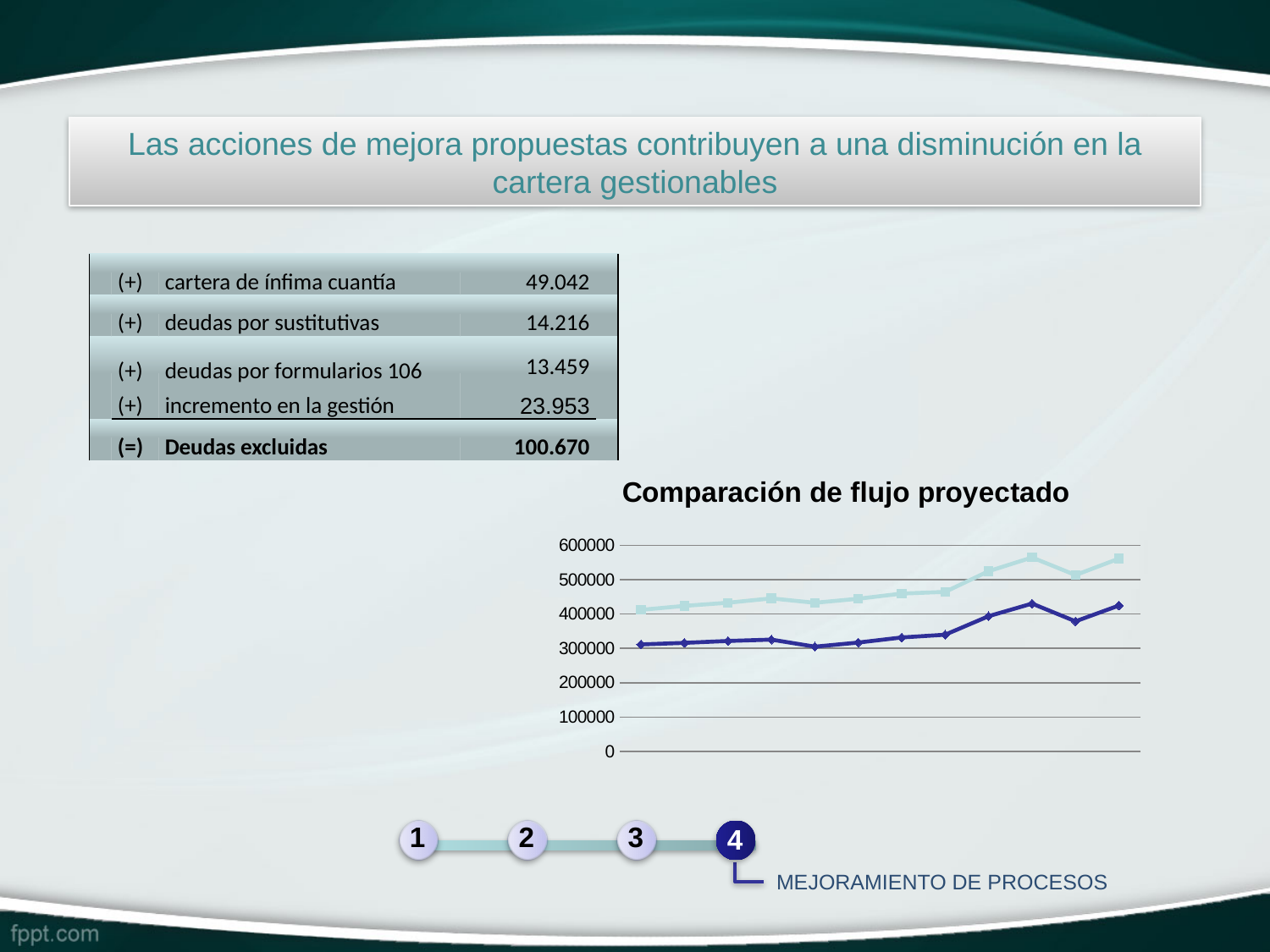
What is the title of the chart on the slide? Comparación de flujo proyectado In the 'Comparación de flujo proyectado' chart, do the values of the light blue line generally rise or fall from left to right? rise In the 'Comparación de flujo proyectado' chart, is the first value of the dark blue line greater or less than 400000? less How many data points does each line in the 'Comparación de flujo proyectado' chart have? 12 What is the highest value shown on the vertical axis of the 'Comparación de flujo proyectado' chart? 600000 What type of chart is shown under the title 'Comparación de flujo proyectado'? line chart In the 'Comparación de flujo proyectado' chart, is the last value of the light blue line greater or less than 500000? greater In the 'Comparación de flujo proyectado' chart, is the highest value of the dark blue line greater or less than 500000? less In the 'Comparación de flujo proyectado' chart, which line has higher values throughout, the light blue line or the dark blue line? the light blue line How many lines (series) are plotted in the 'Comparación de flujo proyectado' chart? 2 In the 'Comparación de flujo proyectado' chart, do the values of the dark blue line generally rise or fall from left to right? rise